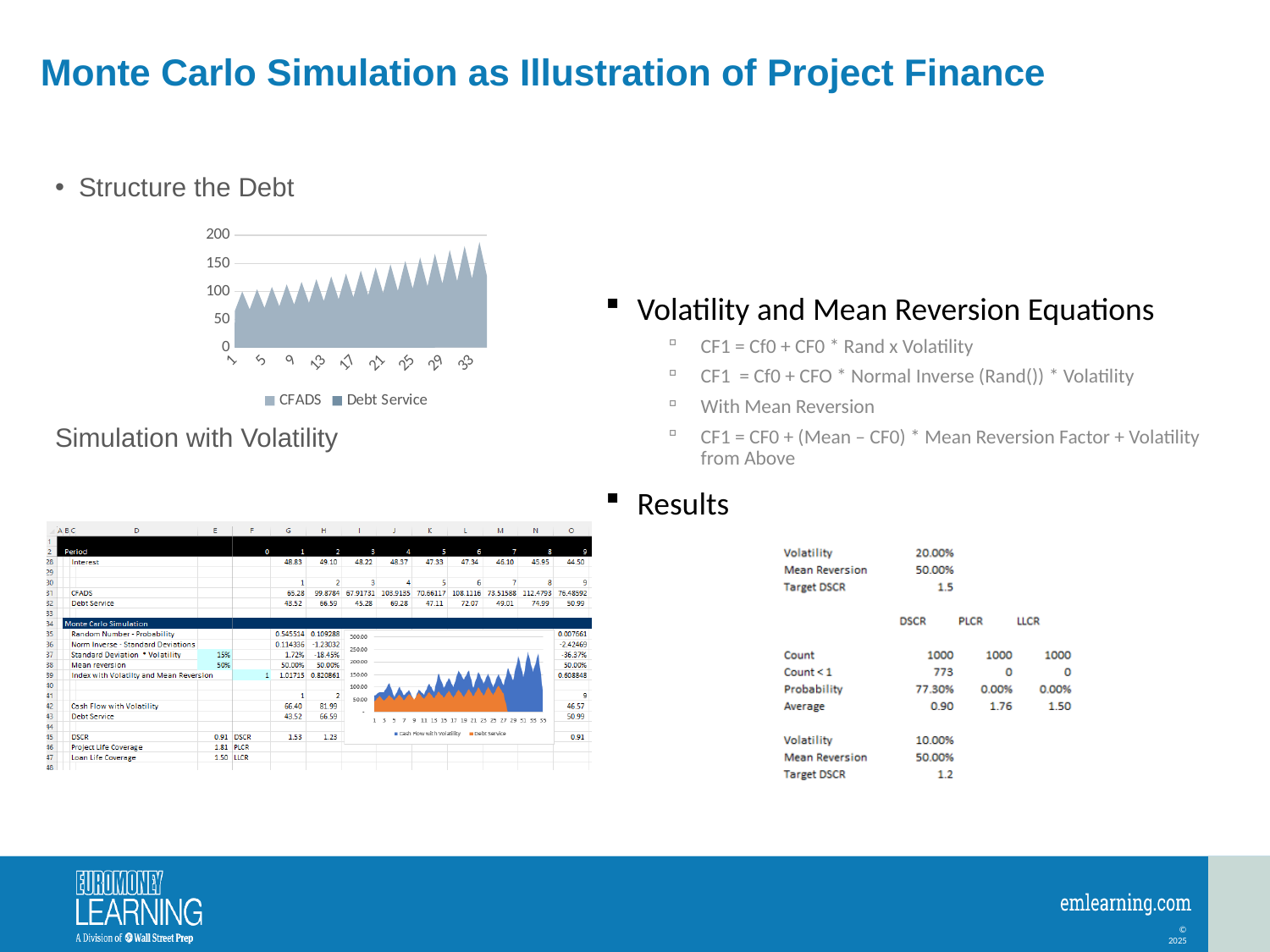
What kind of chart is the chart under 'Structure the Debt' at the top left of the slide? Area chart How many series does the legend of the small chart embedded in the spreadsheet screenshot list? 2 What is the highest value shown on the y axis of the top-left chart? 200 In the top-left chart, is the highest plotted value greater or less than 150? greater In the small chart embedded in the spreadsheet screenshot, is the highest plotted value greater or less than 200? greater How many series does the legend of the top-left chart list? 2 What is the last x-axis label shown on the top-left chart? 33 In the top-left chart, is the value at x = 1 greater or less than 150? less Do the values in the top-left chart generally rise or fall along the x axis? Rise What are the two series named in the legend of the top-left chart? CFADS and Debt Service What kind of chart is the small chart embedded in the spreadsheet screenshot at the bottom left of the slide? Area chart